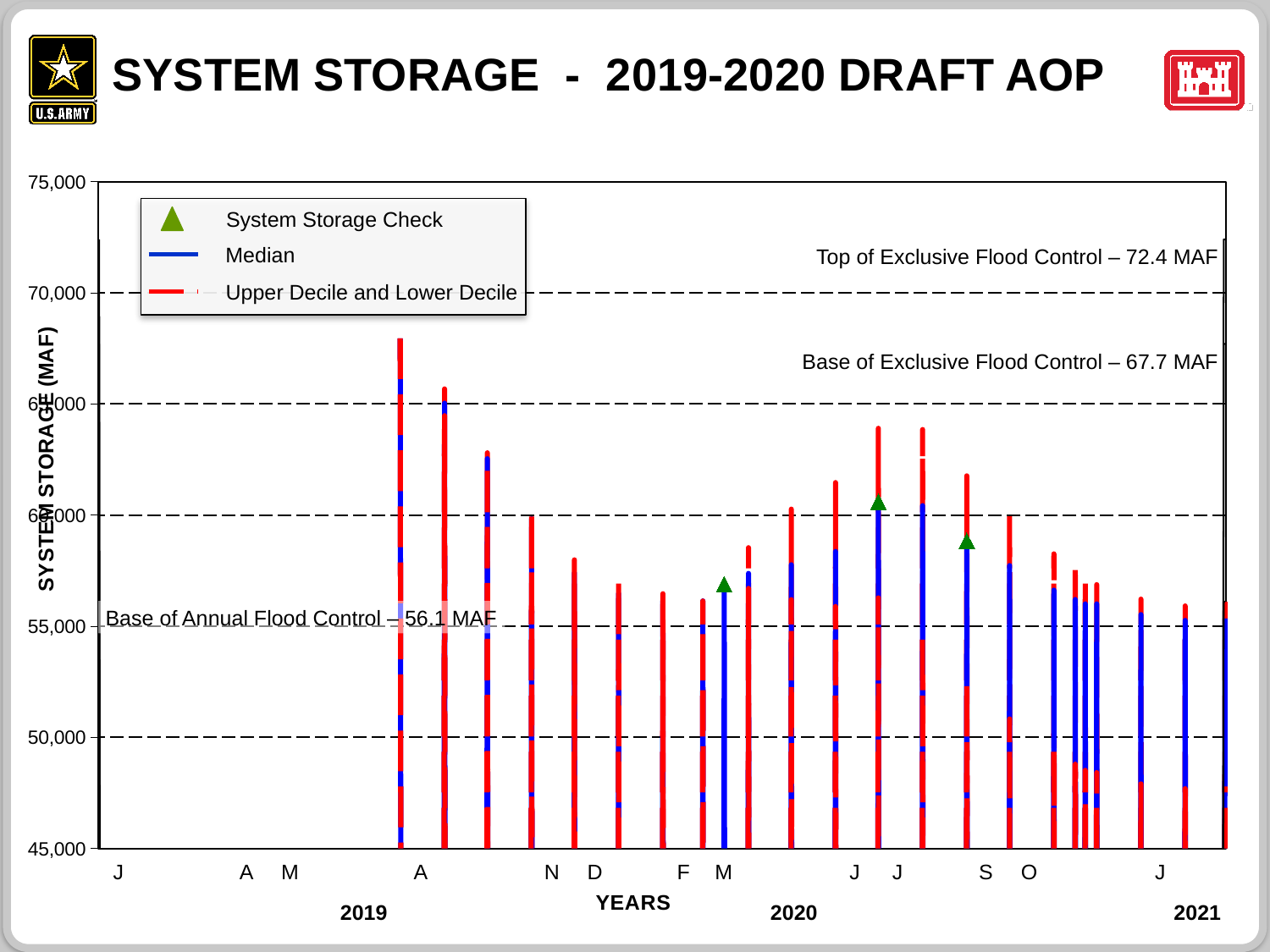
Do the bar tops rise or fall from April 2019 to November 2019? fall What value is given for the Base of Exclusive Flood Control line? 67.7 MAF What value is given for the Base of Annual Flood Control line? 56.1 MAF How many green System Storage Check triangles are plotted on the chart? 3 How many entries does the chart legend list? 3 Is the top of the red bar around February 2020 greater or less than 60,000? less What is the title of the chart slide? SYSTEM STORAGE - 2019-2020 DRAFT AOP Is the top of the tallest red bar (around April 2019) greater or less than 65,000? greater What is the highest value shown on the vertical axis? 75,000 What kind of chart is shown on the slide? bar chart What is the label of the vertical axis? SYSTEM STORAGE (MAF) What value is given for the Top of Exclusive Flood Control line? 72.4 MAF